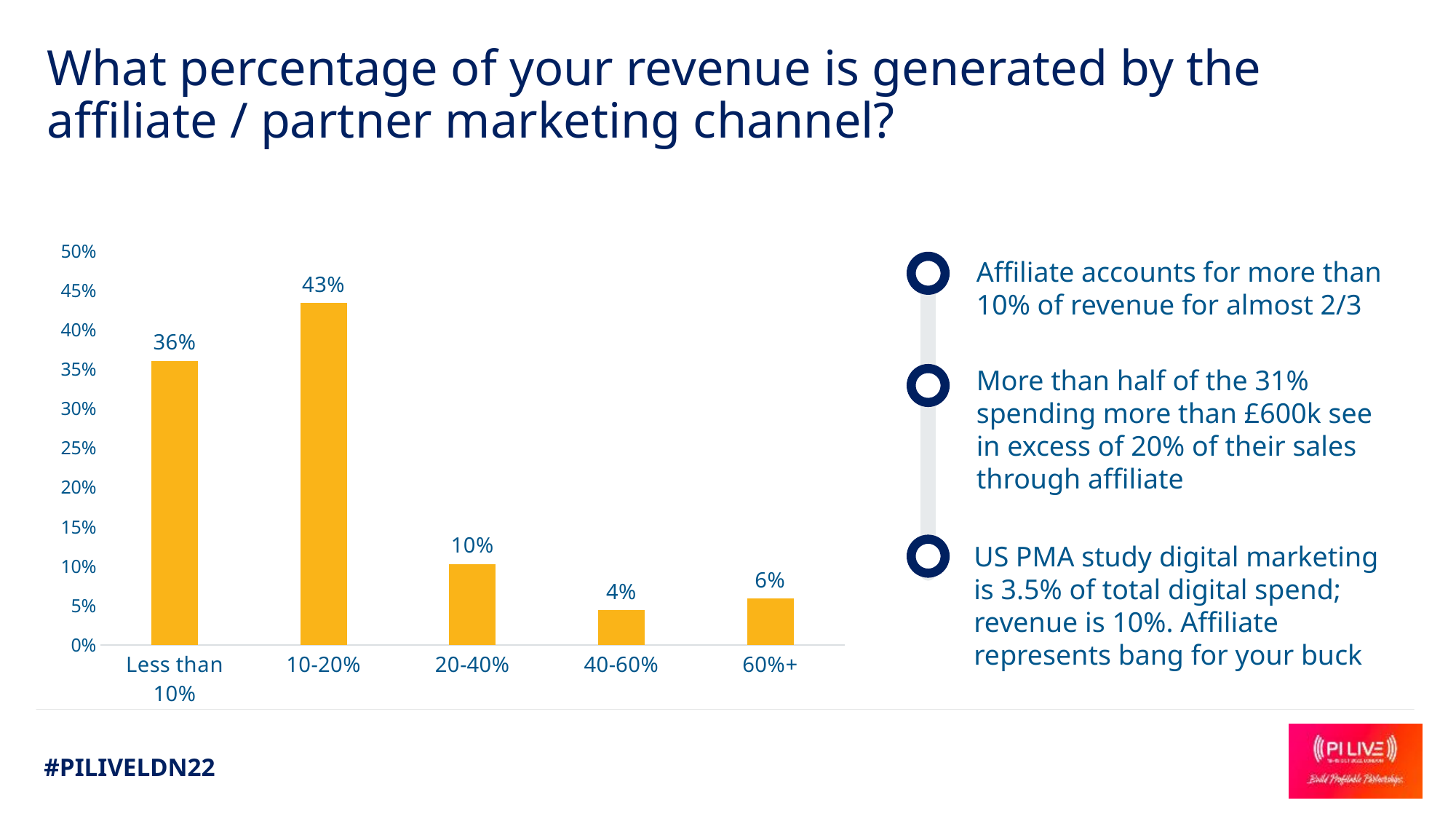
Which category has the lowest value? 40-60% What is the value for the Less than 10% category? 36% What is the value for the 60%+ category? 6% How many categories are shown on the x axis? 5 Which category has the highest value? 10-20% What is the value for the 40-60% category? 4% Which is larger, the value for 20-40% or the value for 60%+? 20-40% What is the value for the 10-20% category? 43% What colour are the bars in the chart? yellow/orange What kind of chart is shown on the slide? bar chart Is the value for 10-20% greater or less than 40%? greater What is the difference between the values for 10-20% and Less than 10%? 7%